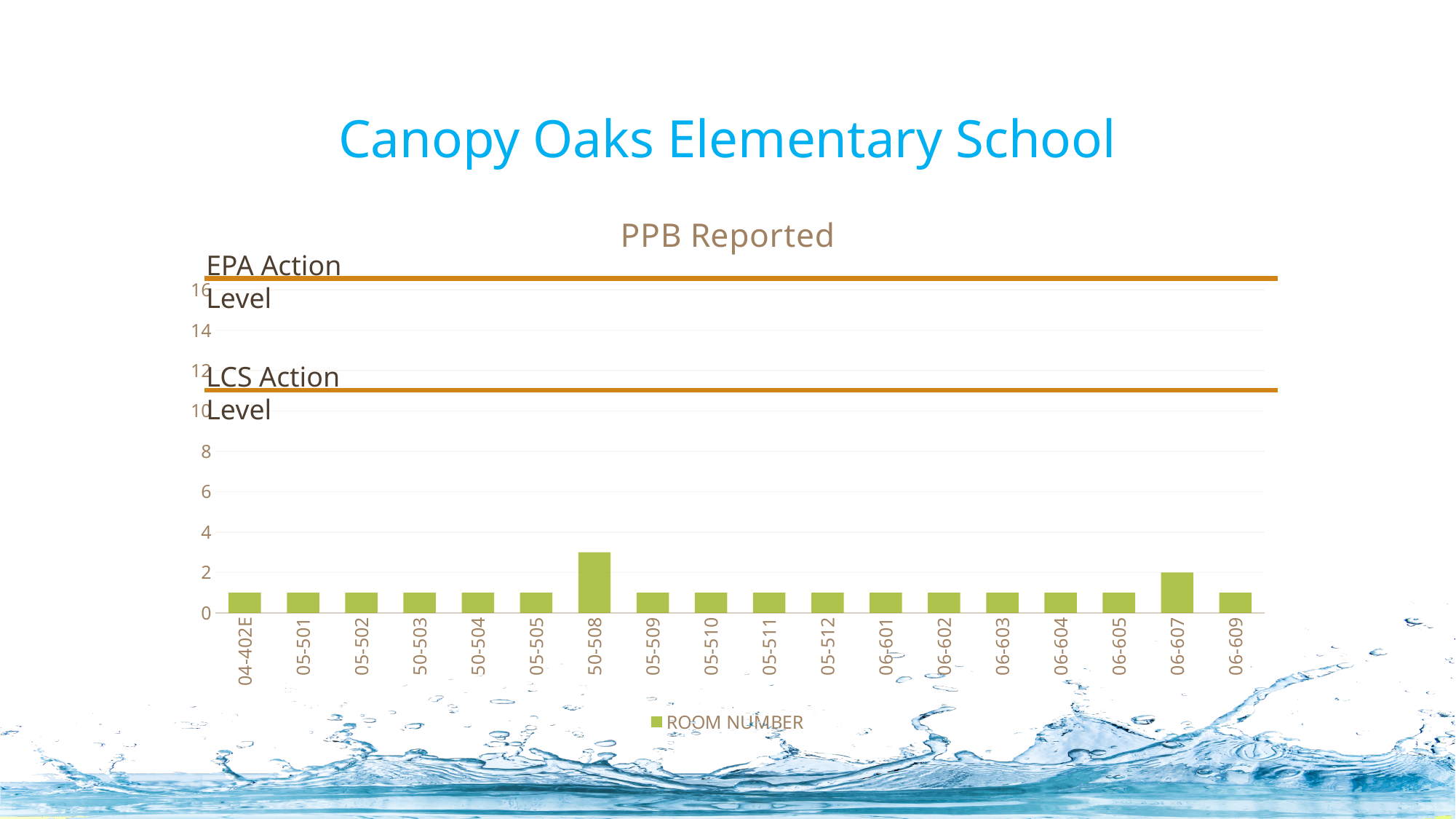
What is the PPB reported value for room 06-607? 2 Which is larger, the value for room 50-508 or the value for room 06-607? 50-508 Is the value for room 50-508 greater or less than 2? greater How many series does the legend list? 1 Is the value for room 05-501 greater or less than 2? less How many room categories are plotted on the x axis? 18 What is the title of the chart? PPB Reported Is the value for room 50-508 greater or less than 4? less Which is larger, the value for room 06-607 or the value for room 06-609? 06-607 Which room has the highest PPB reported value? 50-508 What kind of chart is shown on the slide? bar chart What is the name of the series shown in the legend? ROOM NUMBER